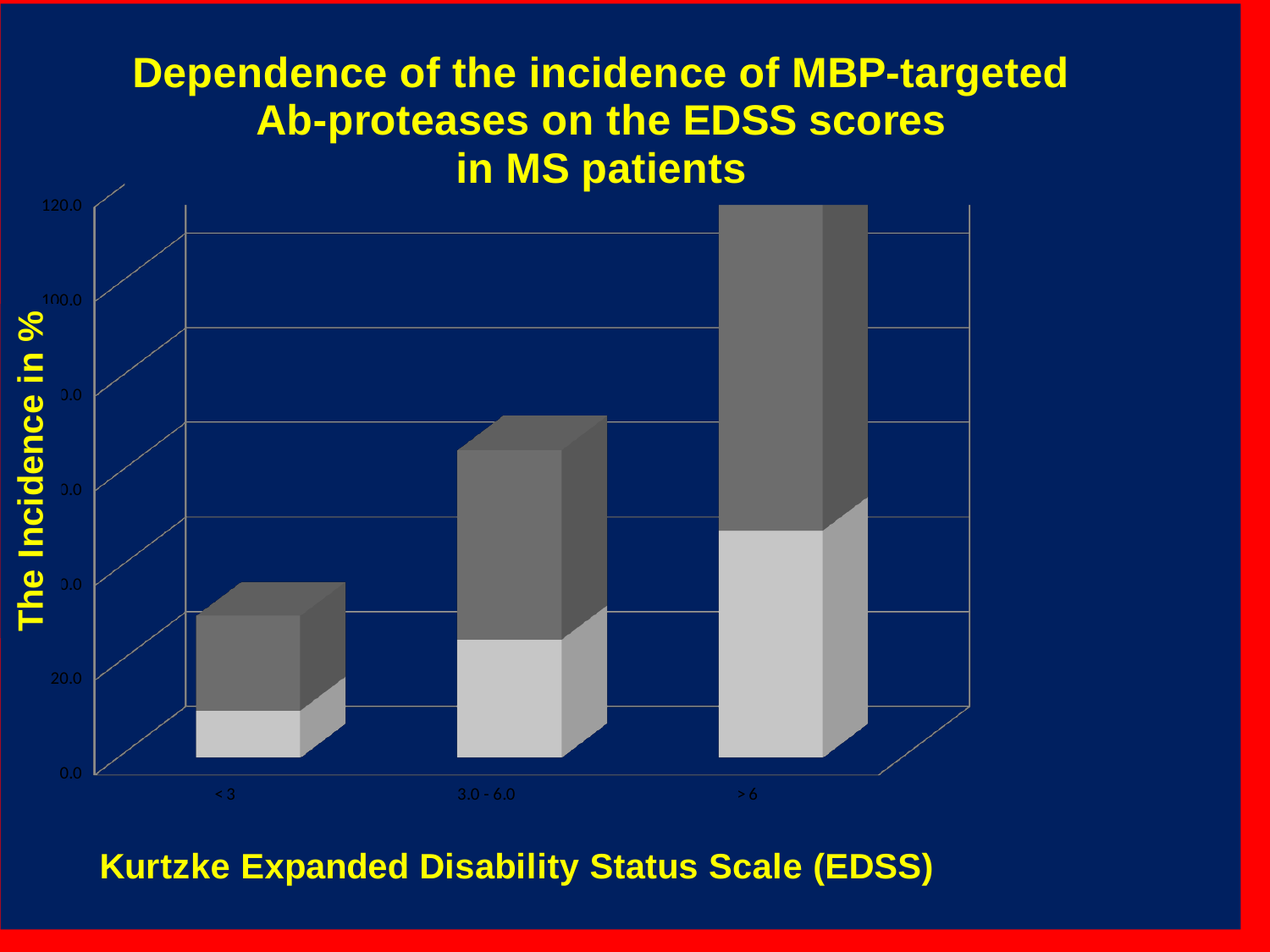
Is the total height of the bar for "3.0 - 6.0" greater or less than 40? greater How many EDSS score categories are shown on the x axis? 3 Which EDSS category has the shortest bar? < 3 What kind of chart is shown on the slide? Stacked bar chart Which bar is taller, the one for "< 3" or the one for "> 6"? > 6 What is the label of the y axis? The Incidence in % What scale is named in the x-axis label below the chart? Kurtzke Expanded Disability Status Scale (EDSS) Is the total height of the bar for "> 6" greater or less than 80? greater Is the total height of the bar for "< 3" greater or less than 60? less Do the bar heights rise or fall as the EDSS score increases along the x axis? Rise Which EDSS category has the tallest bar? > 6